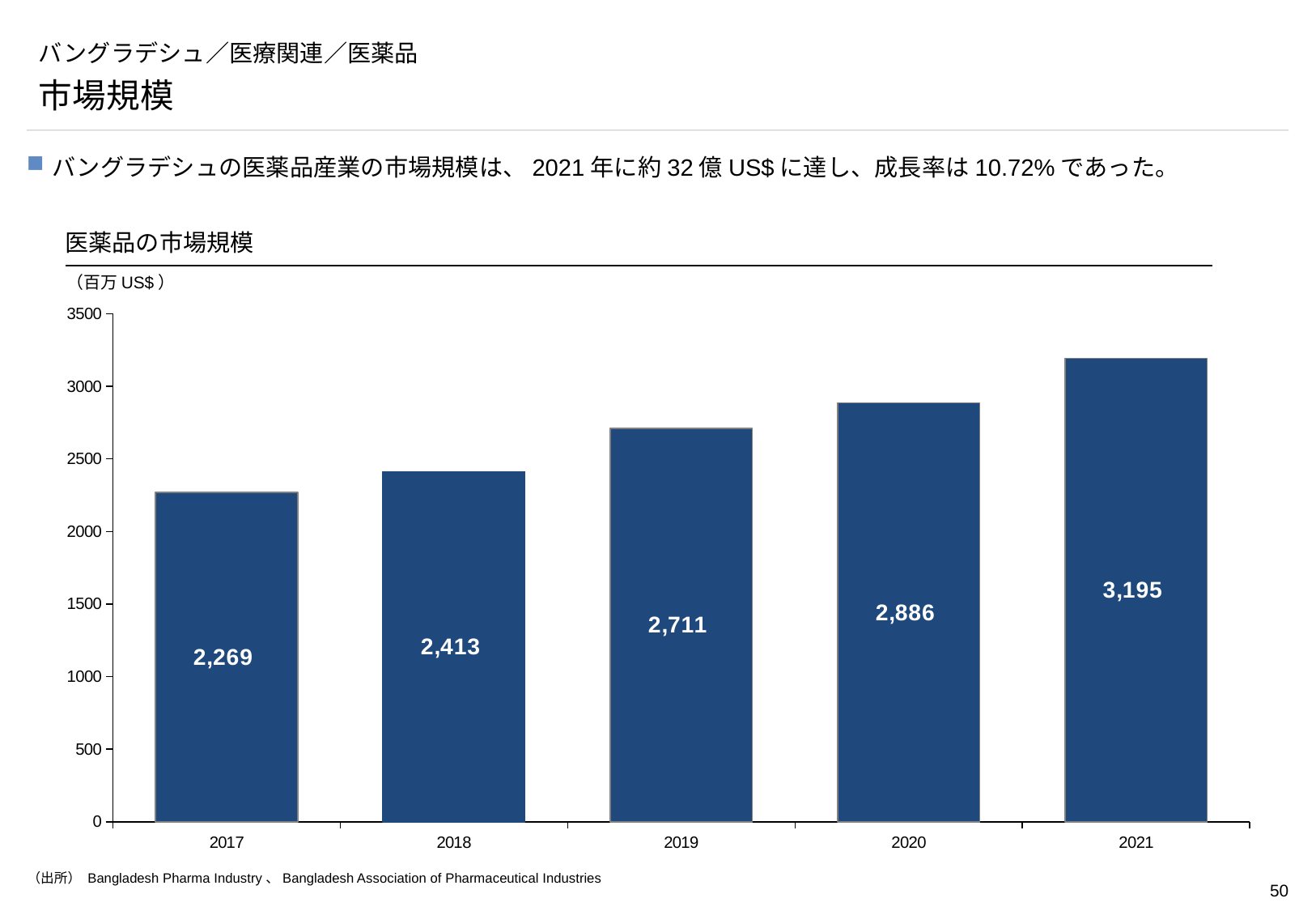
What is the difference between the values for 2021 and 2020? 309 How many years are shown on the x axis? 5 What is the value for 2017? 2,269 What is the value for 2019? 2,711 Which year has the lowest value? 2017 What is the difference between the values for 2018 and 2017? 144 Do the values rise or fall from 2017 to 2021? rise Is the value for 2020 greater or less than 3000? less Which is larger, the value for 2019 or the value for 2018? 2019 What kind of chart is this? bar chart Which year has the highest value? 2021 What is the value for 2021? 3,195